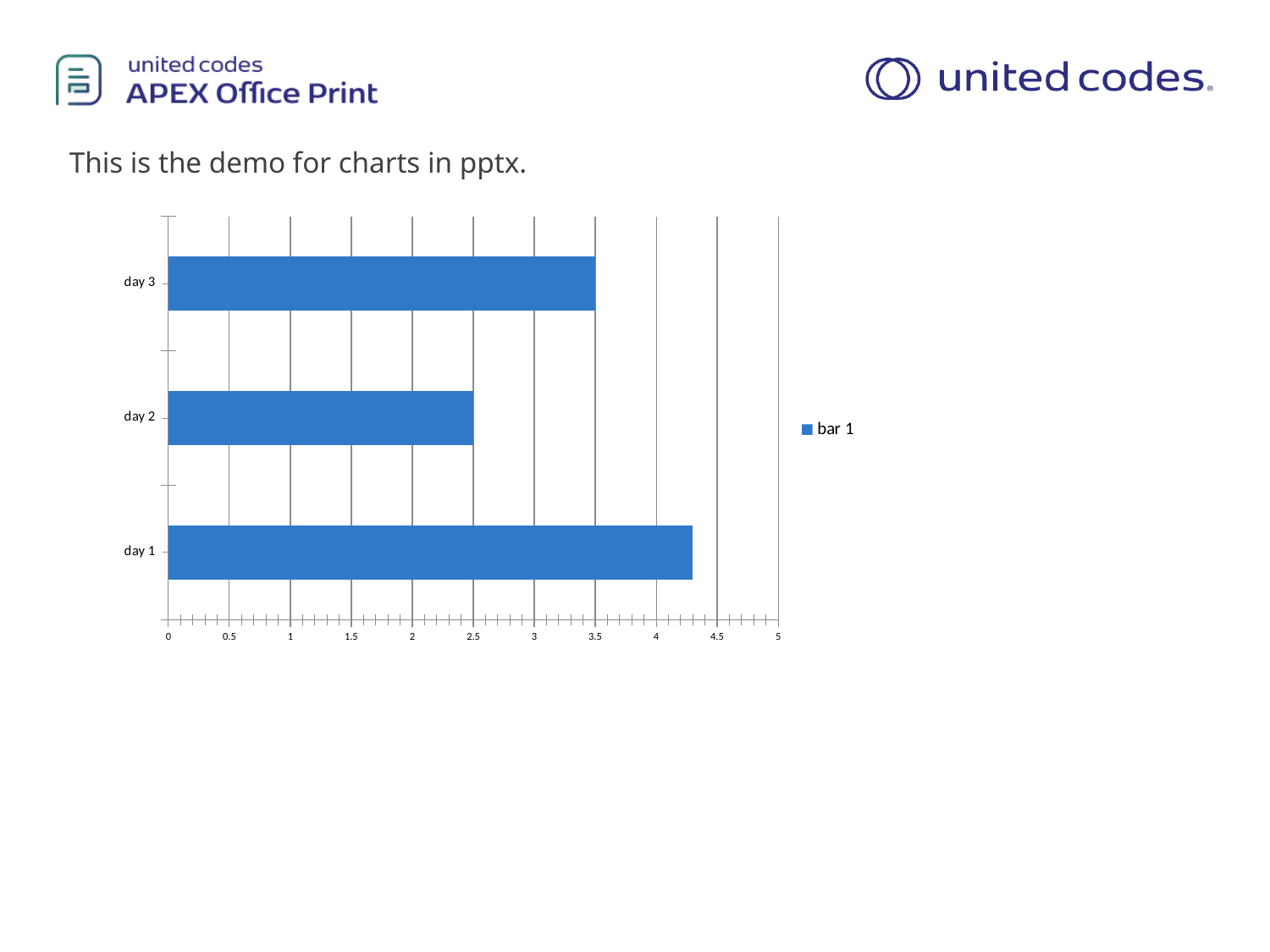
Which category has the lowest value? day 2 What is the value for day 3? 3.5 Is the value for day 1 greater or less than 4? greater How many categories are plotted in the chart? 3 What is the name of the series shown in the legend? bar 1 What is the value for day 2? 2.5 What is the difference between the values for day 3 and day 2? 1 Which is larger, the value for day 3 or the value for day 2? day 3 Which category has the highest value? day 1 Is the value for day 2 greater or less than 3? less How many series does the chart's legend list? 1 What kind of chart is shown on the slide? bar chart